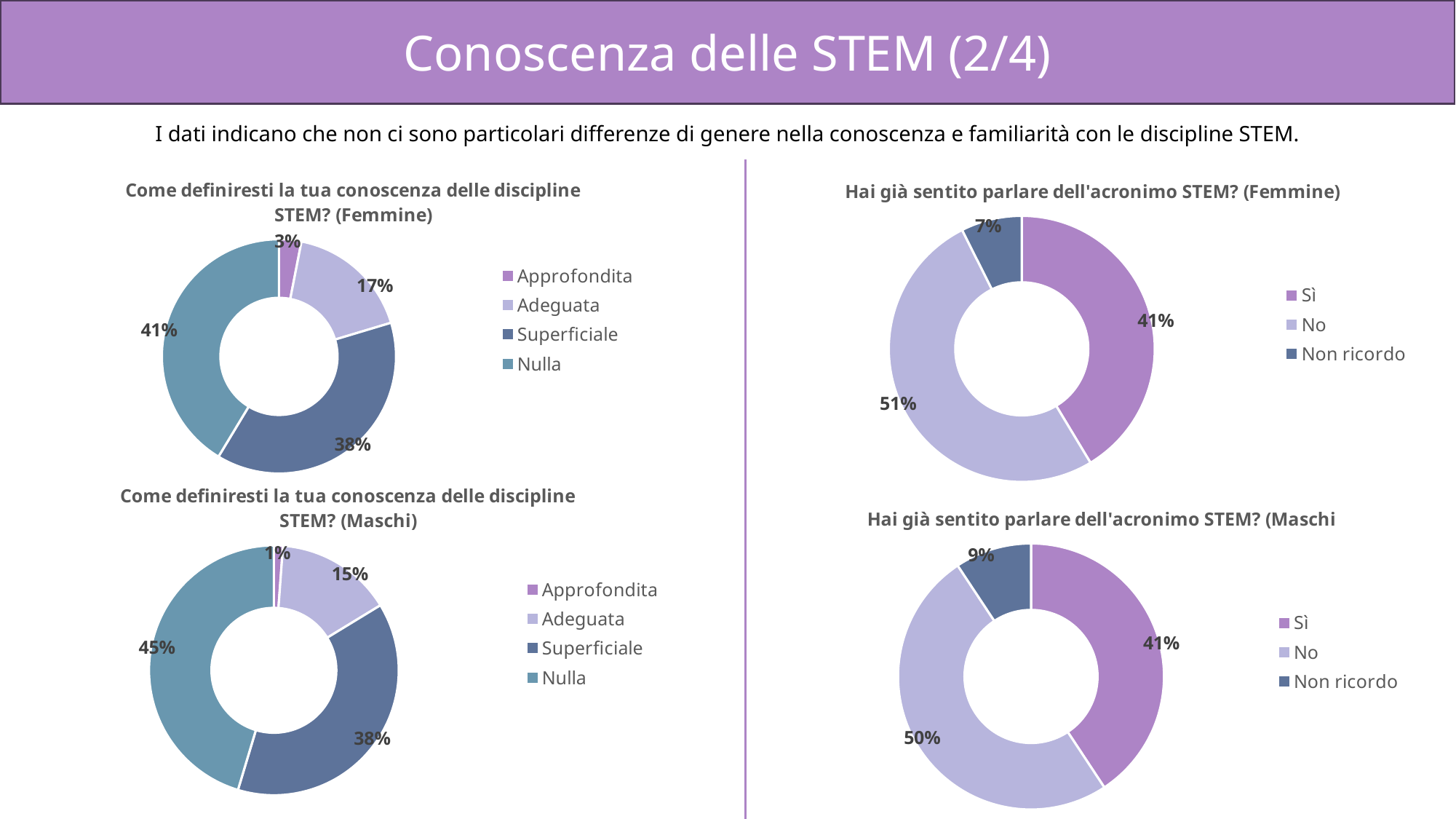
In the chart "Come definiresti la tua conoscenza delle discipline STEM? (Femmine)", which category has the smallest share? Approfondita In the chart "Come definiresti la tua conoscenza delle discipline STEM? (Maschi)", which category has the largest share? Nulla In the chart "Come definiresti la tua conoscenza delle discipline STEM? (Femmine)", what percentage is labelled for Nulla? 41% In the chart "Come definiresti la tua conoscenza delle discipline STEM? (Maschi)", what percentage is labelled for Adeguata? 15% In the chart "Hai già sentito parlare dell'acronimo STEM? (Femmine)", what percentage answered No? 51% In the chart "Hai già sentito parlare dell'acronimo STEM? (Maschi)", which is larger, Sì or No? No What kind of chart is "Come definiresti la tua conoscenza delle discipline STEM? (Femmine)"? Doughnut chart In the chart "Come definiresti la tua conoscenza delle discipline STEM? (Femmine)", what is the difference between the Adeguata and Approfondita percentages? 14% How many categories does the legend list in the chart "Hai già sentito parlare dell'acronimo STEM? (Maschi)"? 3 In the chart "Hai già sentito parlare dell'acronimo STEM? (Maschi)", what percentage answered Non ricordo? 9% In the chart "Hai già sentito parlare dell'acronimo STEM? (Femmine)", which answer has the smallest share? Non ricordo In the chart "Come definiresti la tua conoscenza delle discipline STEM? (Maschi)", what is the difference between the Nulla and Superficiale percentages? 7%